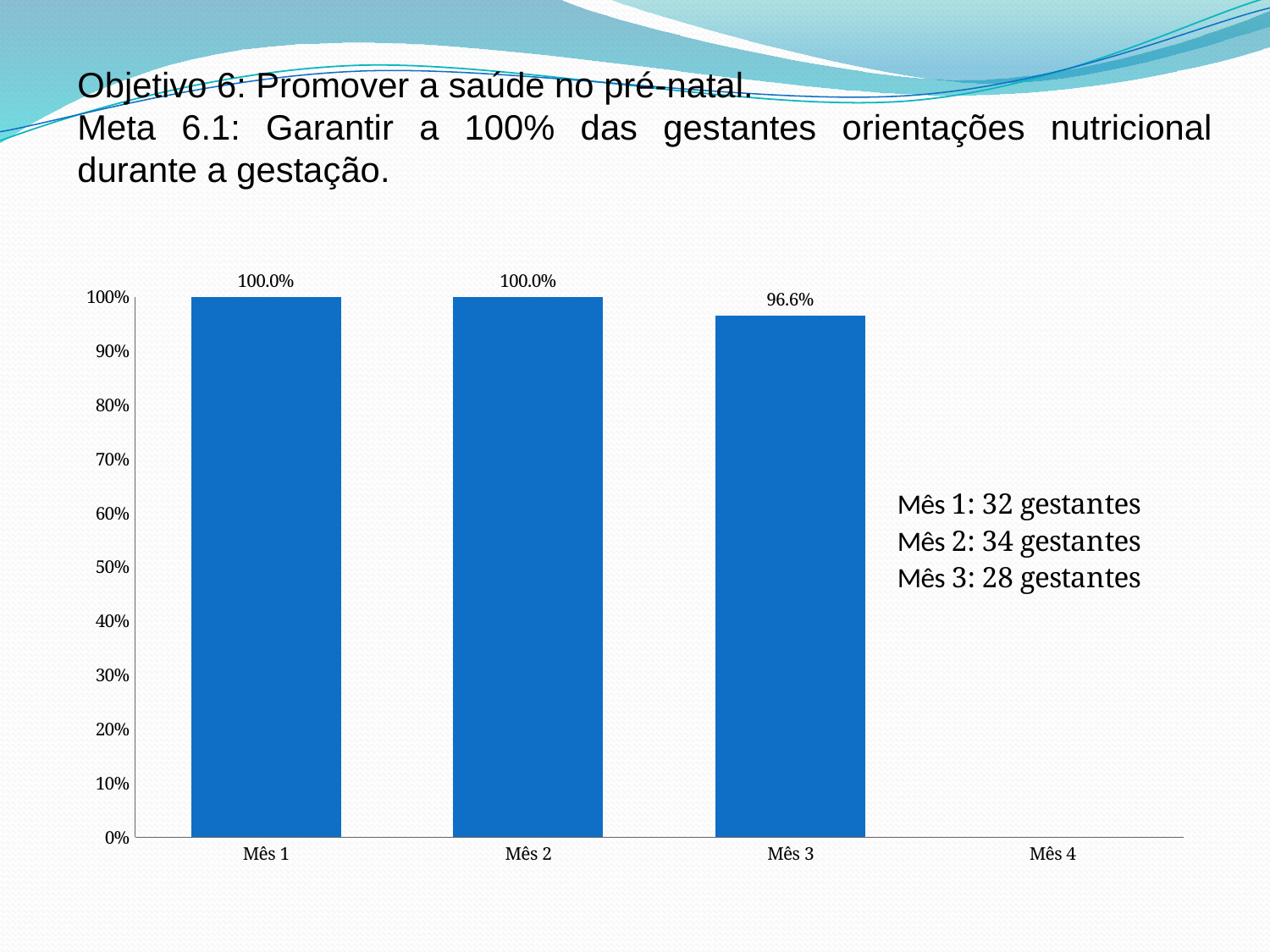
What is the value for Mês 3? 96.6% How many categories are shown on the x axis? 4 What is the difference between the value for Mês 1 and the value for Mês 3? 3.4% What is the value for Mês 2? 100.0% Which month has the lowest value among the bars shown? Mês 3 Which is larger, the value for Mês 2 or the value for Mês 3? Mês 2 What is the highest value shown on the y axis? 100% What is the value for Mês 1? 100.0% Which category on the x axis has no bar plotted? Mês 4 Is the value for Mês 3 greater or less than 90%? greater Do the values rise or fall from Mês 2 to Mês 3? fall What kind of chart is shown on the slide? bar chart